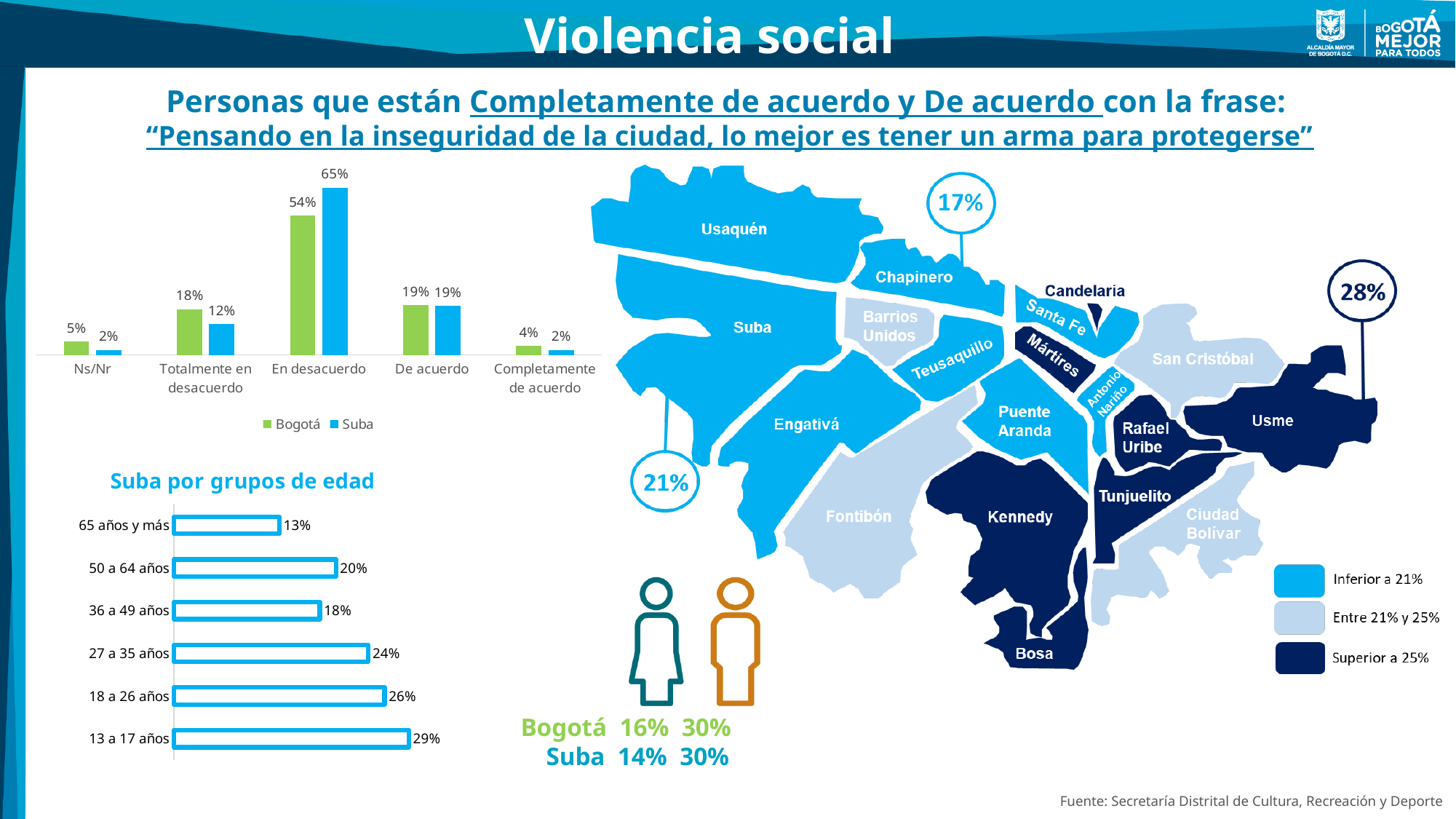
In the top-left bar chart comparing Bogotá and Suba, what is the value for Bogotá in the 'Totalmente en desacuerdo' category? 18% In the top-left bar chart comparing Bogotá and Suba, which category has the highest value for Bogotá? En desacuerdo In the top-left bar chart comparing Bogotá and Suba, what is the difference between the Suba and Bogotá values for 'En desacuerdo'? 11% In the 'Suba por grupos de edad' chart, which age group has the highest value? 13 a 17 años In the top-left bar chart comparing Bogotá and Suba, how many series does the legend list? 2 In the top-left bar chart comparing Bogotá and Suba, what is the value for Suba in the 'En desacuerdo' category? 65% In the top-left bar chart comparing Bogotá and Suba, which is larger for 'Completamente de acuerdo': Bogotá or Suba? Bogotá What kind of chart is 'Suba por grupos de edad'? Bar chart In the top-left bar chart comparing Bogotá and Suba, how many categories are shown on the x axis? 5 In the 'Suba por grupos de edad' chart, what is the difference between the values for '13 a 17 años' and '65 años y más'? 16% In the 'Suba por grupos de edad' chart, what is the value for '27 a 35 años'? 24% In the 'Suba por grupos de edad' chart, which age group has the lowest value? 65 años y más